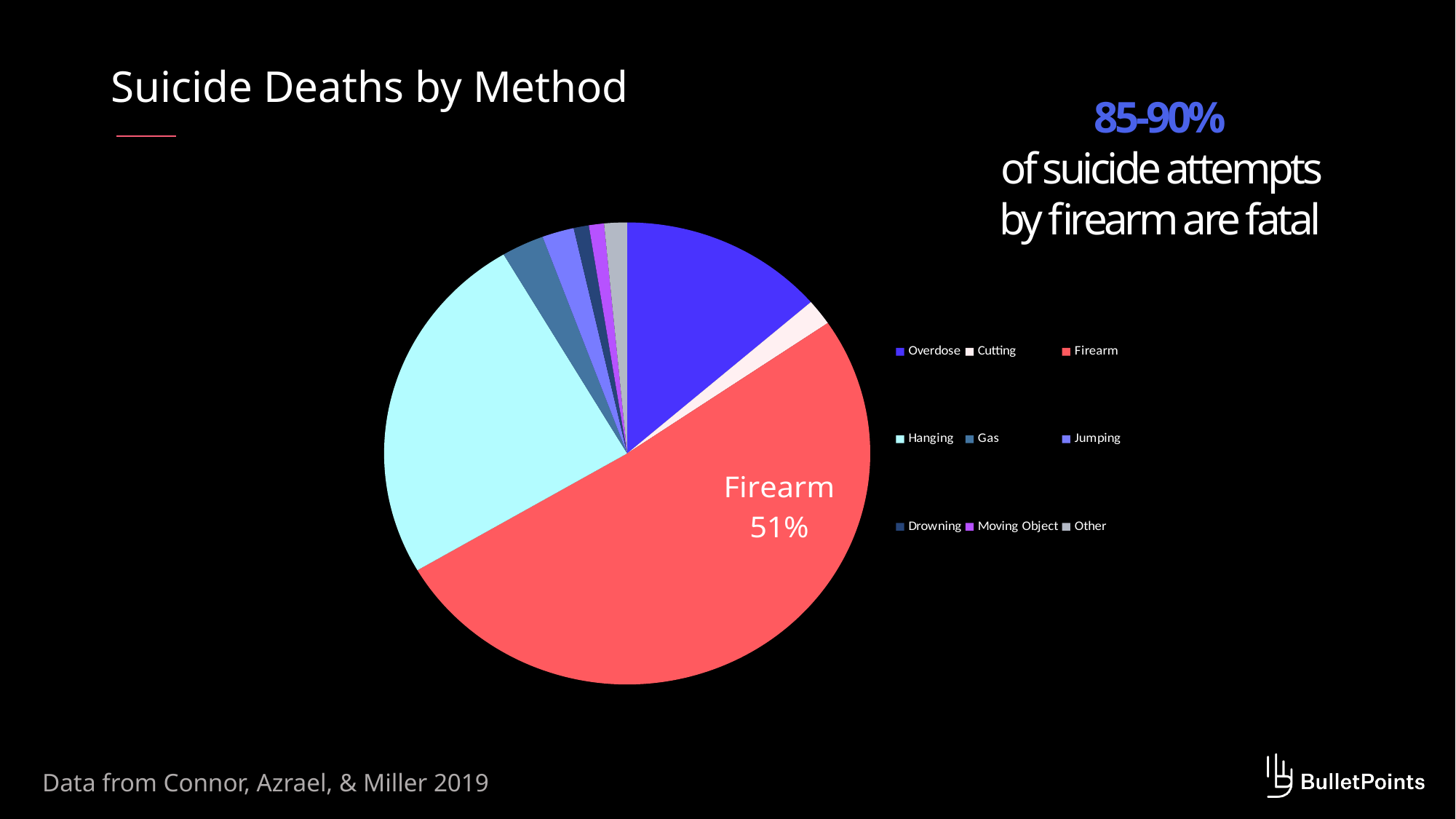
What kind of chart is shown on the slide? pie chart What value is printed on the Firearm slice? 51% Which method has the largest slice of the pie? Firearm What share of the pie does Firearm account for? 51% Is the Firearm share greater or less than 50%? greater Which slice is larger, Overdose or Cutting? Overdose Which slice is larger, Firearm or Hanging? Firearm Which slice is larger, Hanging or Gas? Hanging What colour is the Firearm slice in the pie chart? red What is the title of the chart? Suicide Deaths by Method How many categories does the pie chart's legend list? 9